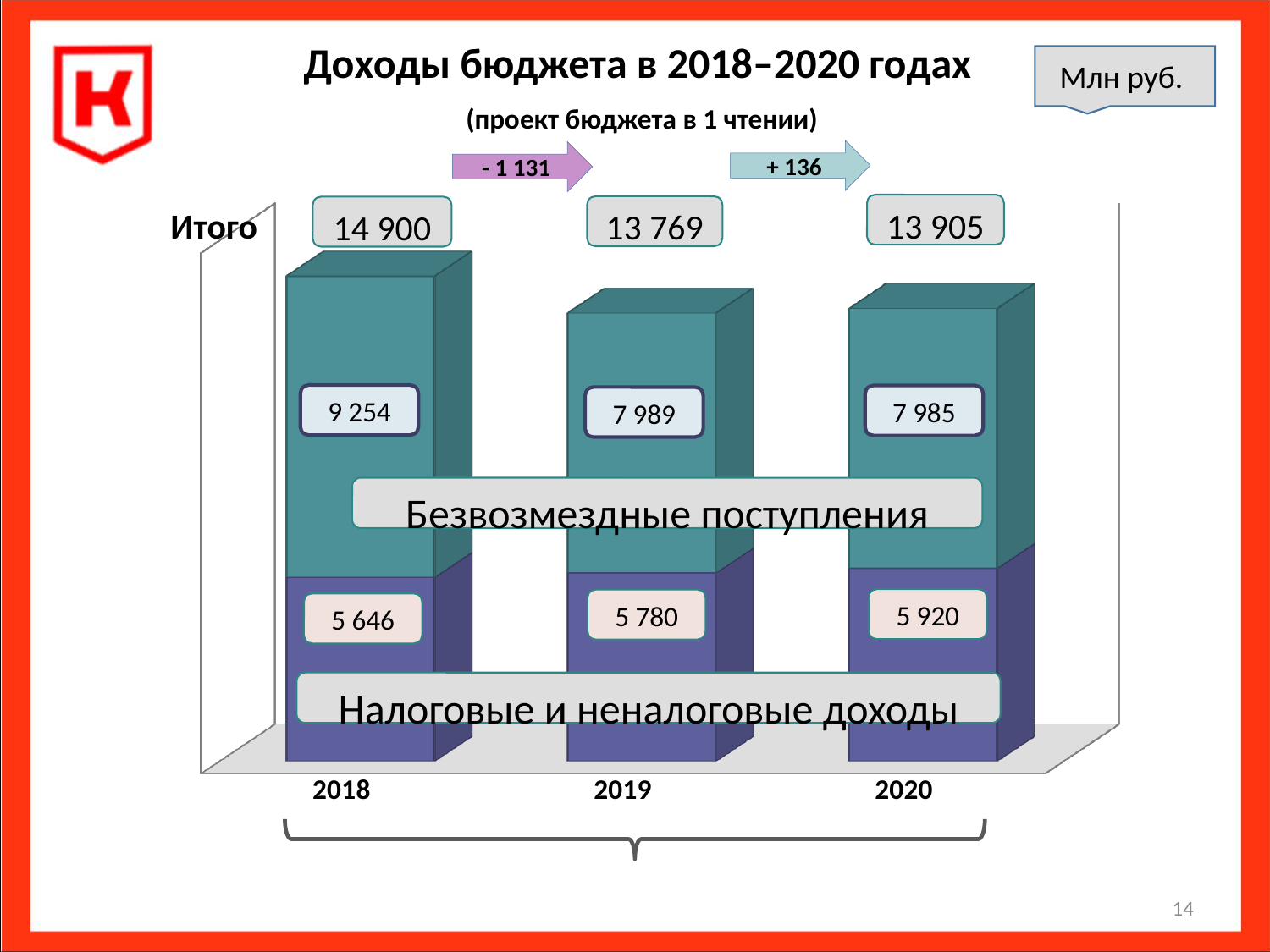
What is the value of Налоговые и неналоговые доходы for 2020? 5 920 Which year has the highest value of Налоговые и неналоговые доходы? 2020 What kind of chart is shown on the slide? Stacked bar chart What is the difference between Безвозмездные поступления in 2018 and in 2019? 1 265 What is the total (Итого) shown for 2019? 13 769 Which year has the lowest total (Итого)? 2019 What is the total (Итого) shown for 2018? 14 900 What is the value of Безвозмездные поступления for 2019? 7 989 In what units are the values on the chart given? Млн руб. Which is larger: Налоговые и неналоговые доходы in 2019 or in 2018? 2019 What is the value of Безвозмездные поступления for 2018? 9 254 How many years are shown on the x axis? 3